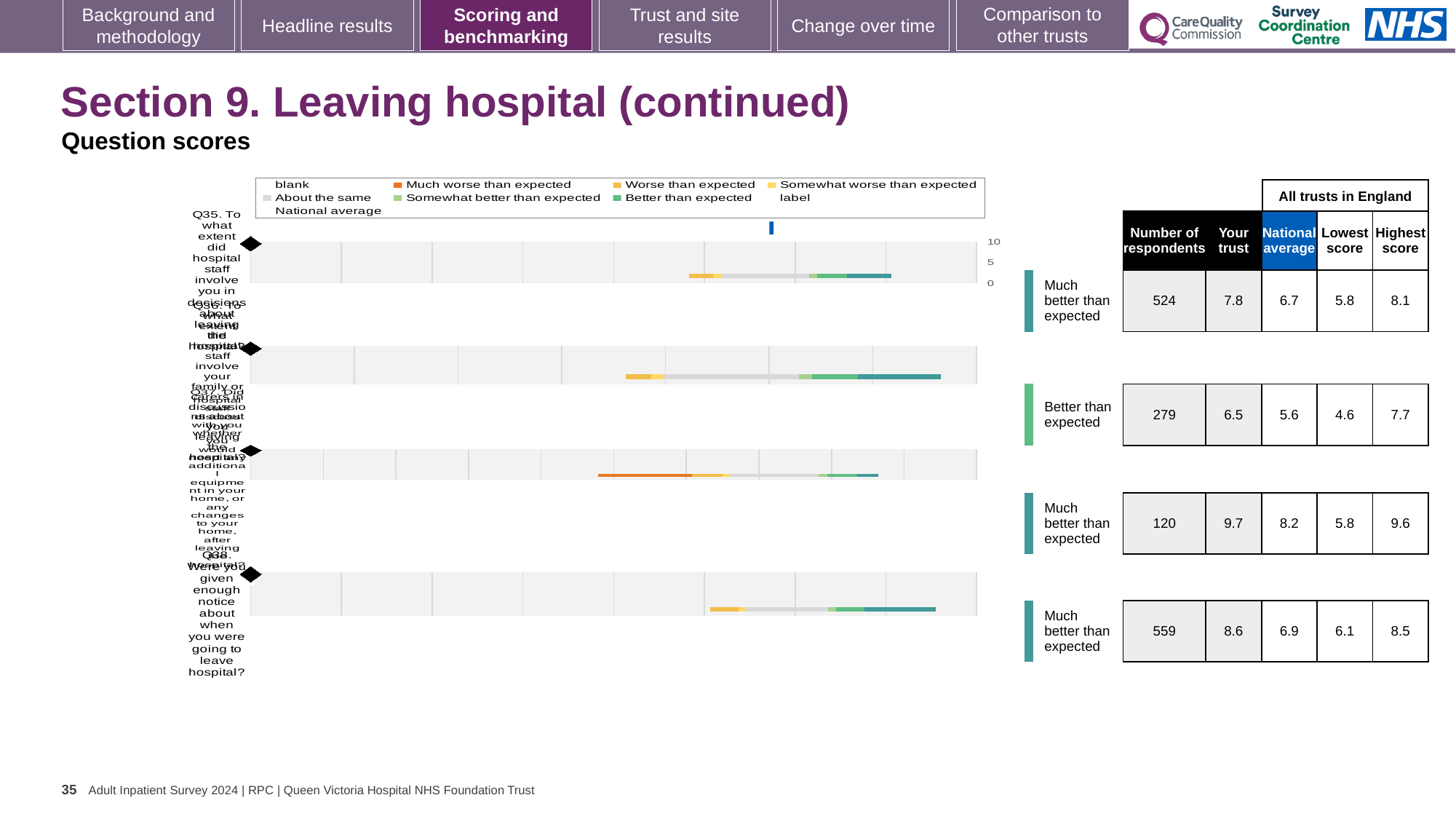
What is the national average for the second row (Q36)? 5.6 How many question rows are plotted on the chart? 4 What kind of chart is used to show the question scores? Bar chart For the first row (Q35), which is larger: the 'Your trust' score or the national average? Your trust (7.8) What is the 'Your trust' score for the first row (Q35, involving you in decisions about leaving hospital)? 7.8 What is the lowest score across all trusts in England for the second row (Q36)? 4.6 What benchmark category is shown next to the second row (Q36)? Better than expected How many respondents are listed for the fourth row (Q38, enough notice about leaving hospital)? 559 For the third row (Q37), what is the difference between the 'Your trust' score and the national average? 1.5 Which question row has the highest 'Your trust' score? Q37 (third row), 9.7 What is the highest score across all trusts in England for the fourth row (Q38)? 8.5 Which question row has the fewest respondents? Q37 (third row), 120